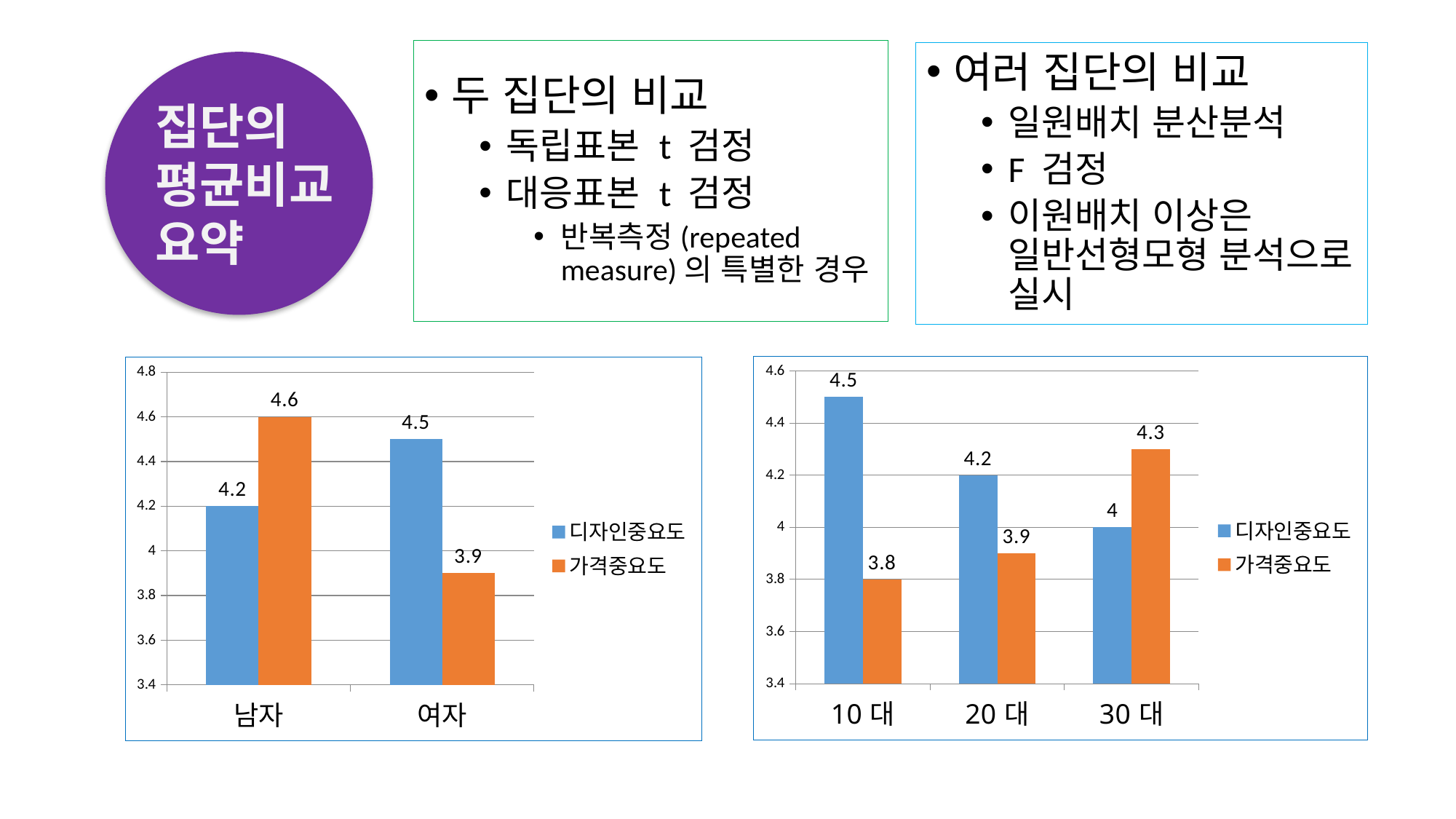
In the left chart, what is the 가격중요도 value for 여자? 3.9 In the left chart, which is larger for 여자: 디자인중요도 or 가격중요도? 디자인중요도 In the right chart, what is the 가격중요도 value for 30 대? 4.3 In the right chart, does the 디자인중요도 value rise or fall from 10 대 to 30 대? fall In the right chart, what is the 디자인중요도 value for 10 대? 4.5 In the left chart, how many series does the legend list? 2 In the right chart, how many categories are shown on the x axis? 3 In the left chart, what is the difference between the 가격중요도 values for 남자 and 여자? 0.7 In the right chart, which age group has the lowest 가격중요도 value? 10 대 In the right chart, what is the difference between the 디자인중요도 and 가격중요도 values for 20 대? 0.3 In the left chart, what is the 디자인중요도 value for 남자? 4.2 What kind of chart is the left chart? bar chart